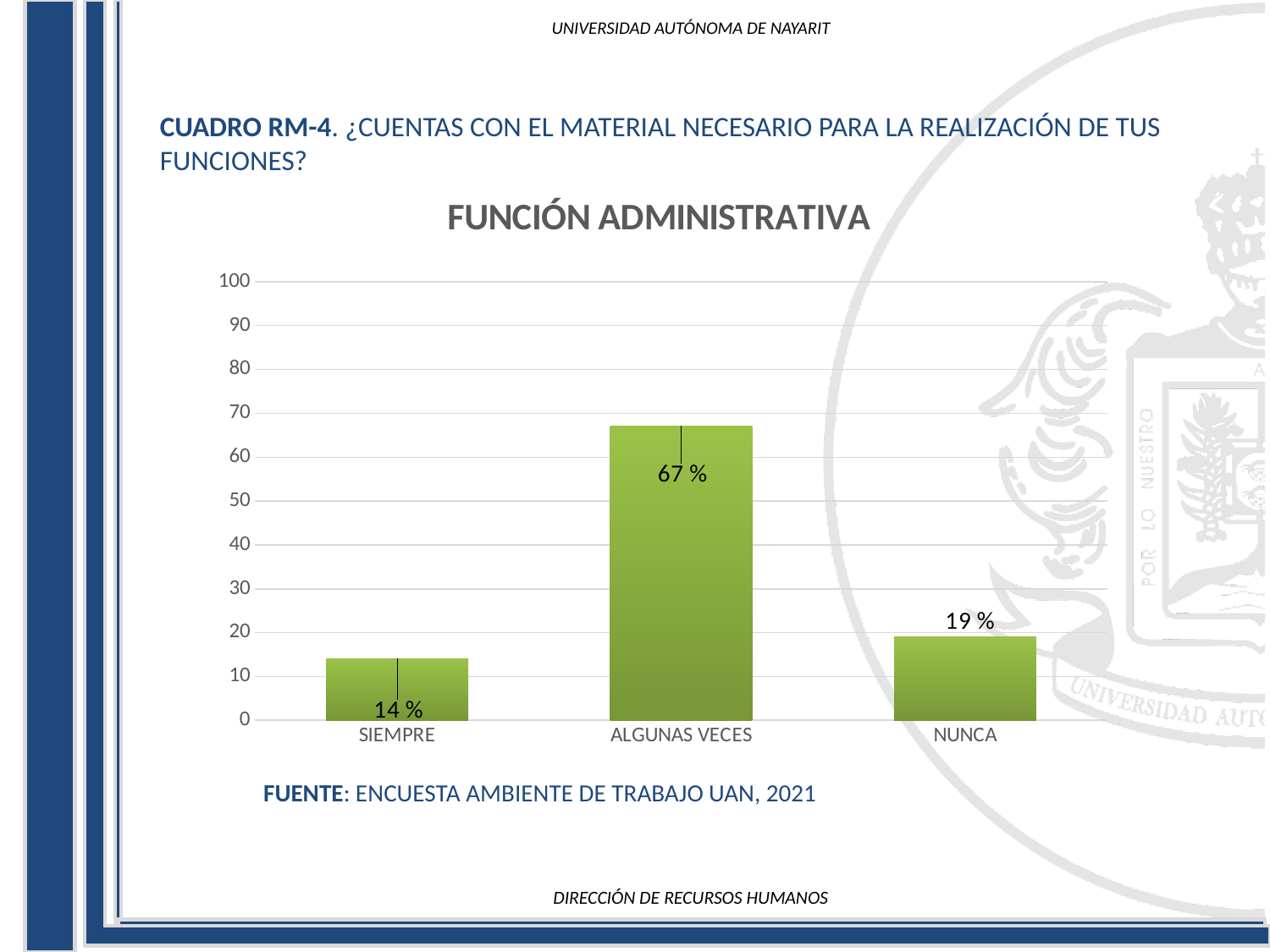
How many categories are shown on the x axis? 3 What is the title of the chart? FUNCIÓN ADMINISTRATIVA What is the difference between the values for NUNCA and SIEMPRE? 5 % What is the difference between the values for ALGUNAS VECES and NUNCA? 48 % Which category has the lowest value? SIEMPRE What is the value for NUNCA? 19 % What kind of chart is shown on the slide? bar chart What is the value for SIEMPRE? 14 % Is the value for ALGUNAS VECES greater or less than 60? greater Which is larger, the value for NUNCA or the value for SIEMPRE? NUNCA Which category has the highest value? ALGUNAS VECES What is the value for ALGUNAS VECES? 67 %